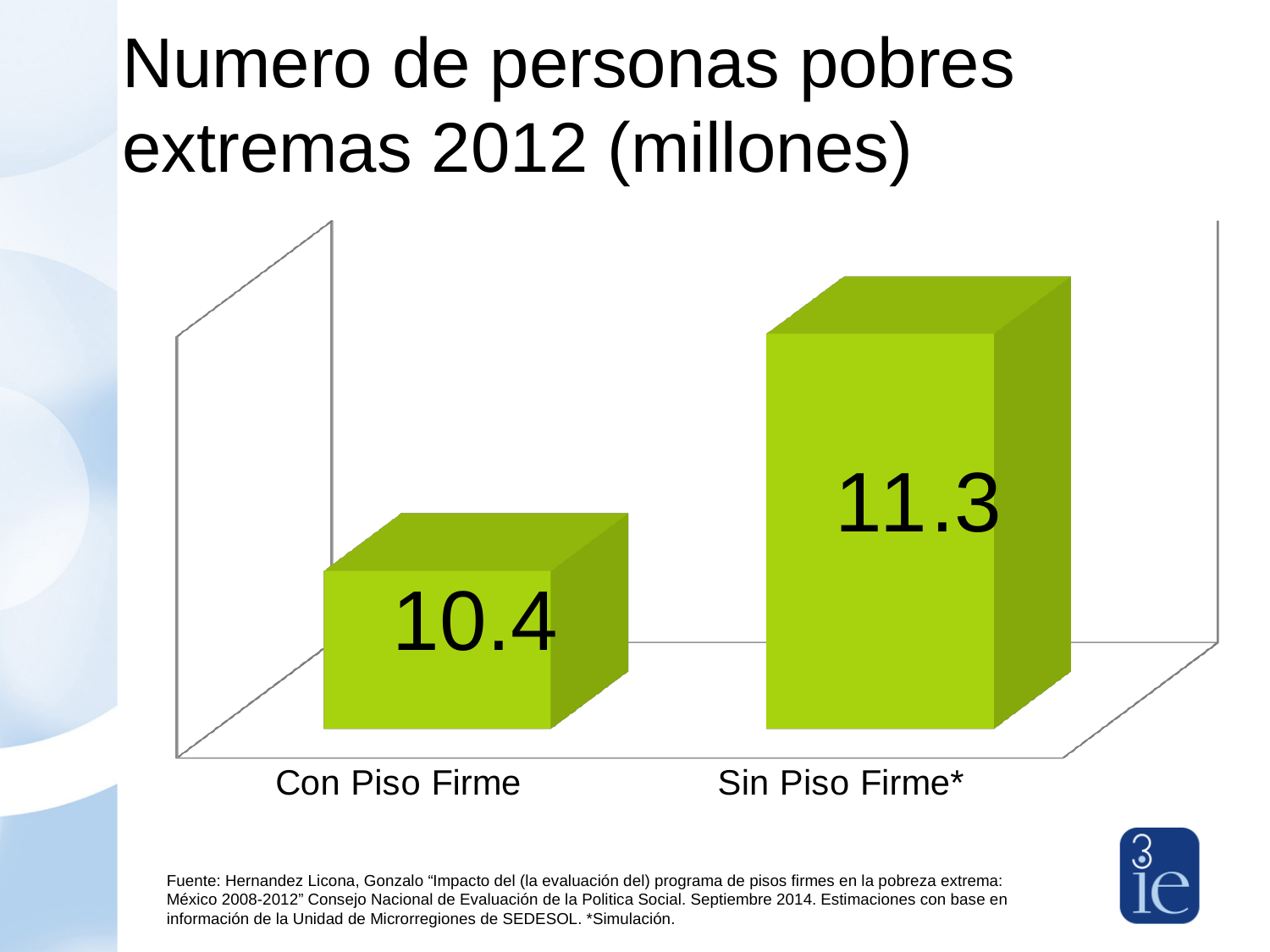
Do the values rise or fall from Con Piso Firme to Sin Piso Firme*? Rise What is the title of the slide containing the chart? Numero de personas pobres extremas 2012 (millones) How many categories are shown in the chart? 2 What kind of chart is shown on the slide? Bar chart Which is larger, the value for Con Piso Firme or the value for Sin Piso Firme*? Sin Piso Firme* What is the value for Sin Piso Firme*? 11.3 Which category has the highest value? Sin Piso Firme* What is the value for Con Piso Firme? 10.4 Which category has the lowest value? Con Piso Firme What colour are the bars in the chart? Green What is the difference between the values for Sin Piso Firme* and Con Piso Firme? 0.9